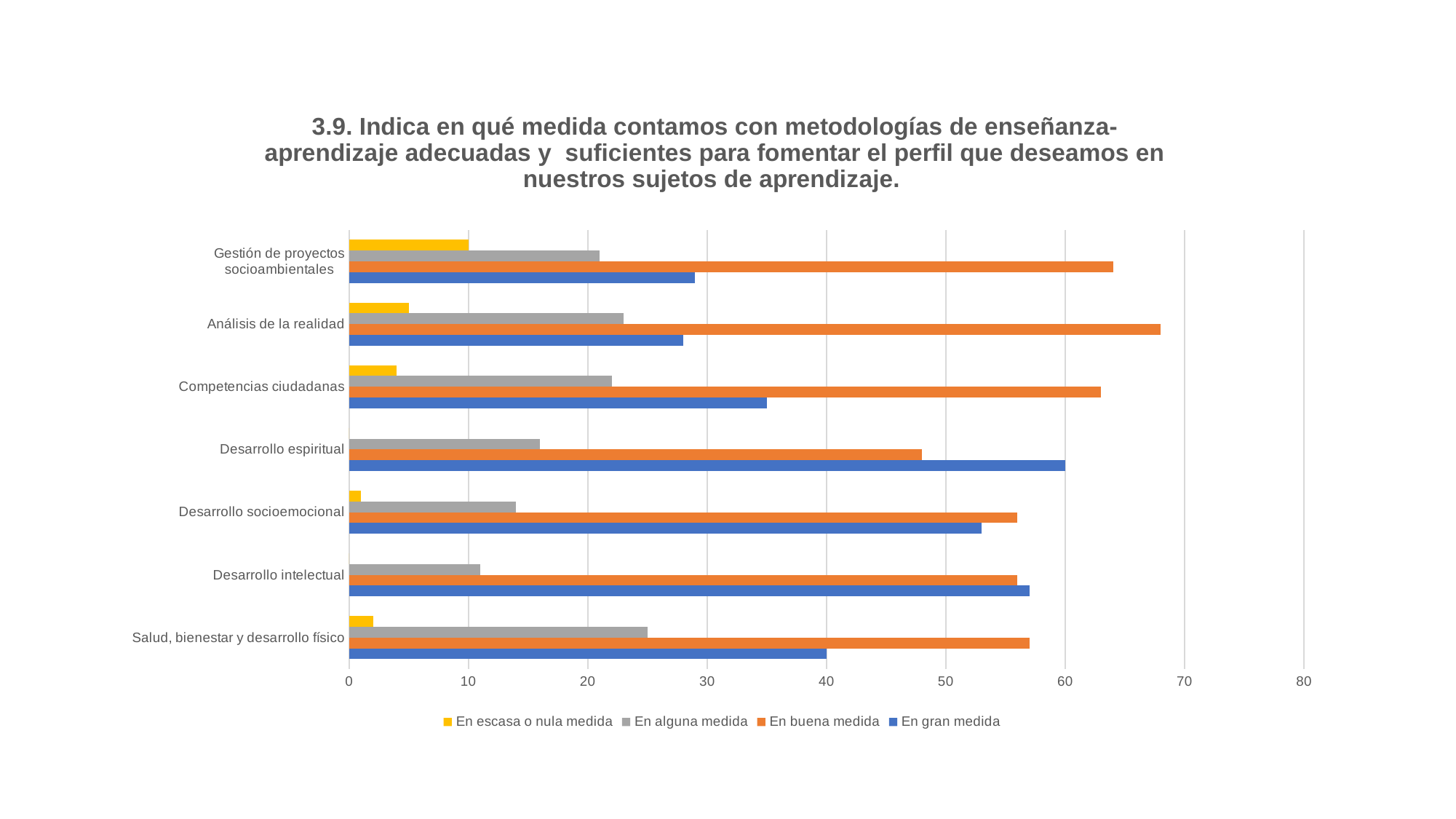
For Gestión de proyectos socioambientales, which is larger: 'En buena medida' or 'En gran medida'? En buena medida How many categories are plotted on the chart? 7 Is the value for 'En gran medida' in Competencias ciudadanas greater or less than 30? greater For Desarrollo espiritual, which is larger: 'En gran medida' or 'En buena medida'? En gran medida What colour represents the series 'En escasa o nula medida' in the legend? yellow Is the value for 'En alguna medida' in Salud, bienestar y desarrollo físico greater or less than 20? greater Which category has the highest value for 'En buena medida'? Análisis de la realidad How many series does the legend list? 4 What kind of chart is shown on the slide? bar chart Which category has the highest value for 'En gran medida'? Desarrollo espiritual Is the value for 'En buena medida' in Desarrollo espiritual greater or less than 50? less Which category has the lowest value for 'En alguna medida'? Desarrollo intelectual